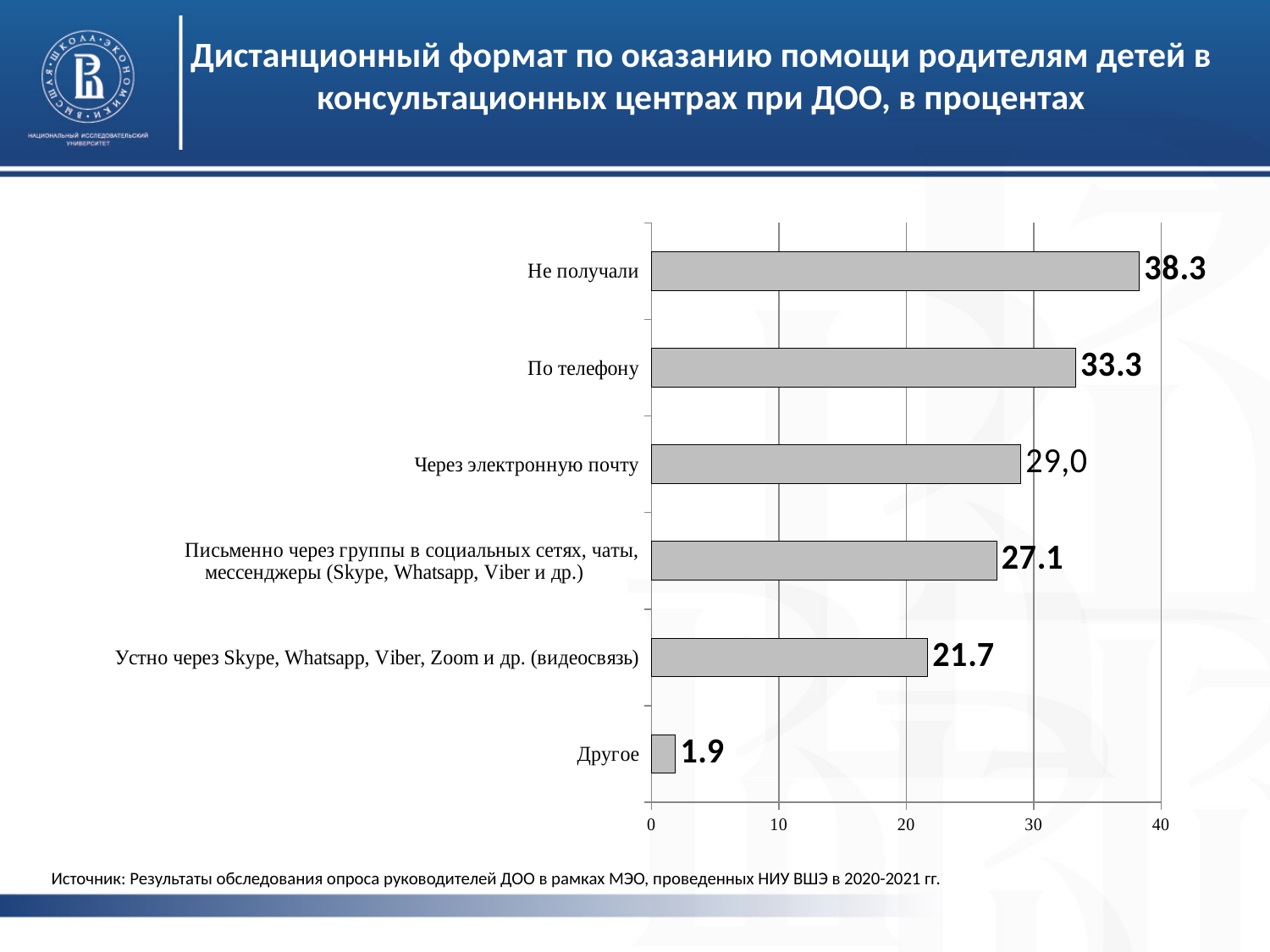
What is the difference between the values for «Не получали» and «По телефону»? 5.0 What is the value for «Устно через Skype, Whatsapp, Viber, Zoom и др. (видеосвязь)»? 21.7 How many categories are shown in the chart? 6 What is the value for «Через электронную почту»? 29,0 Which category has the highest value? Не получали What is the value for «Не получали»? 38.3 What kind of chart is shown on the slide? Bar chart Is the value for «Устно через Skype, Whatsapp, Viber, Zoom и др. (видеосвязь)» greater or less than 20? greater Which category has the lowest value? Другое Which is larger: the value for «По телефону» or the value for «Через электронную почту»? По телефону What is the difference between the values for «Письменно через группы в социальных сетях, чаты, мессенджеры (Skype, Whatsapp, Viber и др.)» and «Другое»? 25.2 What is the value for «По телефону»? 33.3